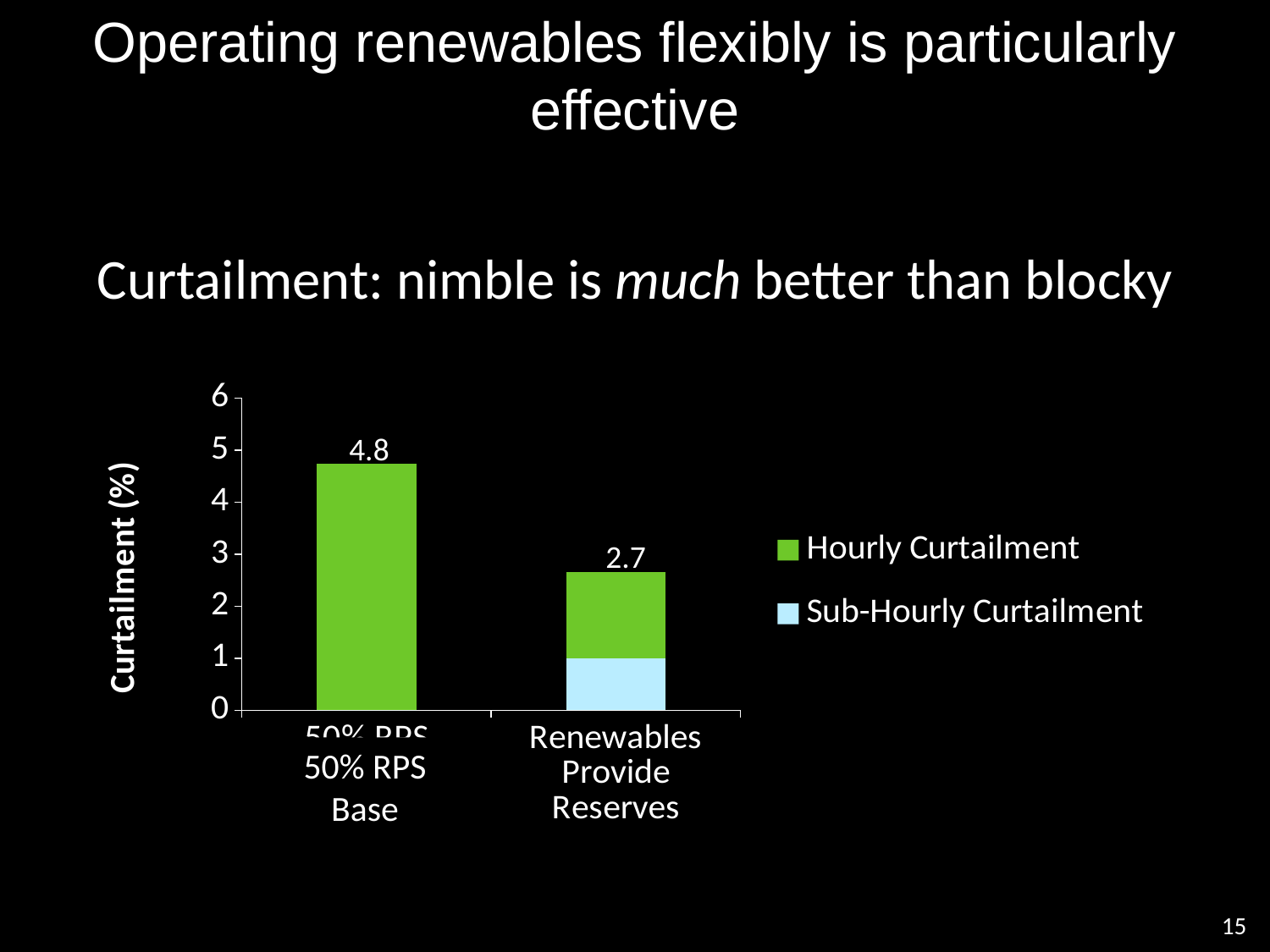
What is the total curtailment value labelled for the Renewables Provide Reserves bar? 2.7 Which category has the higher total curtailment? 50% RPS Base Which series is shown in light blue in the legend? Sub-Hourly Curtailment What kind of chart is shown on the slide? Stacked bar chart Which category has the lower total curtailment? Renewables Provide Reserves What is the label on the vertical axis of the chart? Curtailment (%) How many categories are shown on the x axis of the chart? 2 Is the total curtailment for Renewables Provide Reserves greater or less than 3? less Is the Sub-Hourly Curtailment portion of the Renewables Provide Reserves bar greater or less than 2? less What is the total curtailment value labelled for the 50% RPS Base bar? 4.8 How many series does the chart legend list? 2 What is the difference between the labelled curtailment values for 50% RPS Base and Renewables Provide Reserves? 2.1